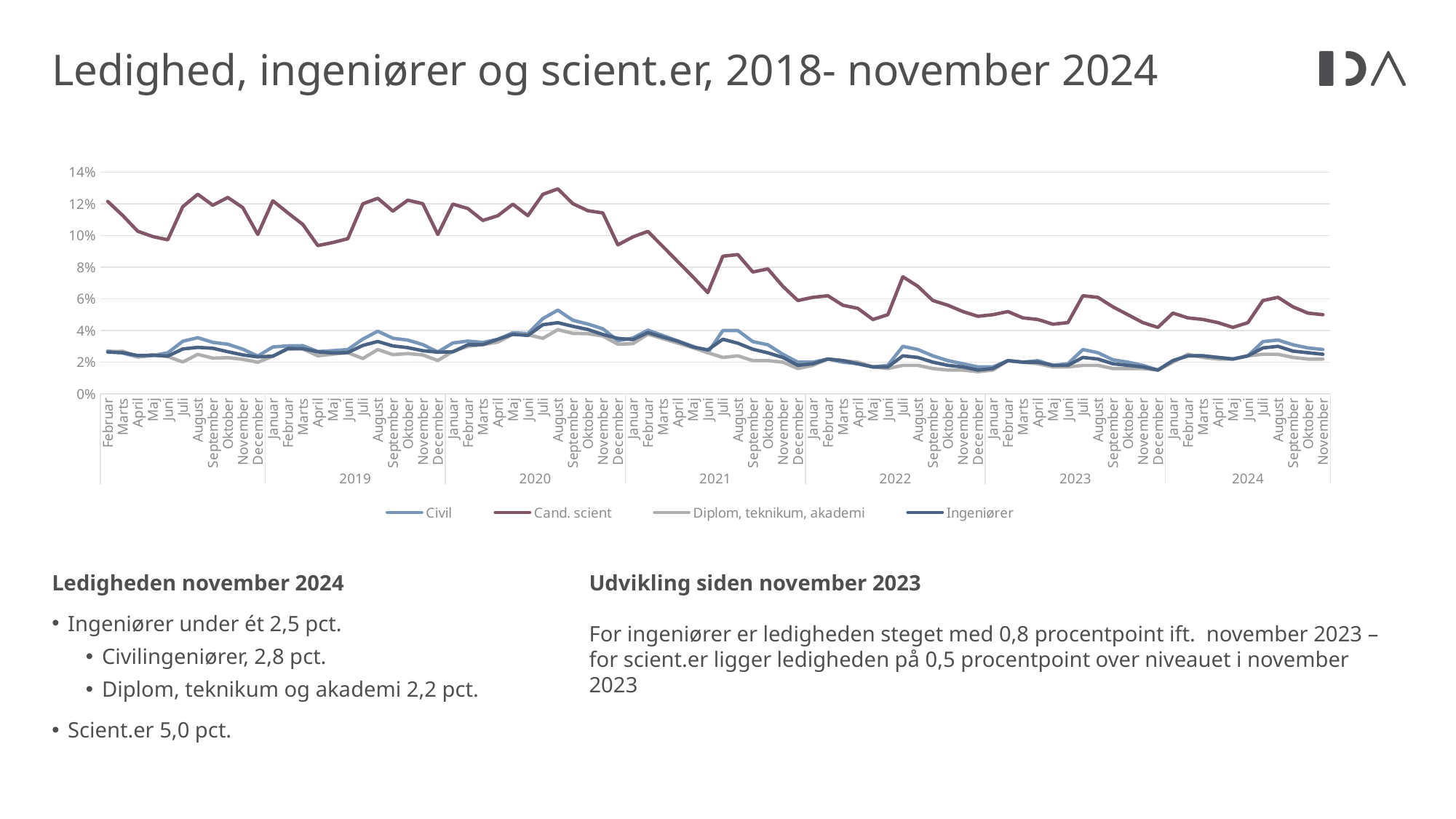
Is the value for Cand. scient in June 2021 greater or less than 8%? less What kind of chart is shown on the slide? line chart Is the value for Cand. scient in August 2020 greater or less than 12%? greater How many series does the chart legend list? 4 In November 2024, which is higher: the Civil series or the Diplom, teknikum, akademi series? Civil According to the slide, what is the unemployment rate for Civilingeniører in November 2024? 2,8 pct. According to the slide, what is the unemployment rate for Scient.er in November 2024? 5,0 pct. Which series does the legend list between 'Cand. scient' and 'Ingeniører'? Diplom, teknikum, akademi Which series has the highest unemployment rate across the whole period? Cand. scient Does the Cand. scient line overall rise or fall from 2018 to November 2024? fall Is the value for Cand. scient in November 2024 greater or less than 6%? less What is the title of the chart slide? Ledighed, ingeniører og scient.er, 2018- november 2024